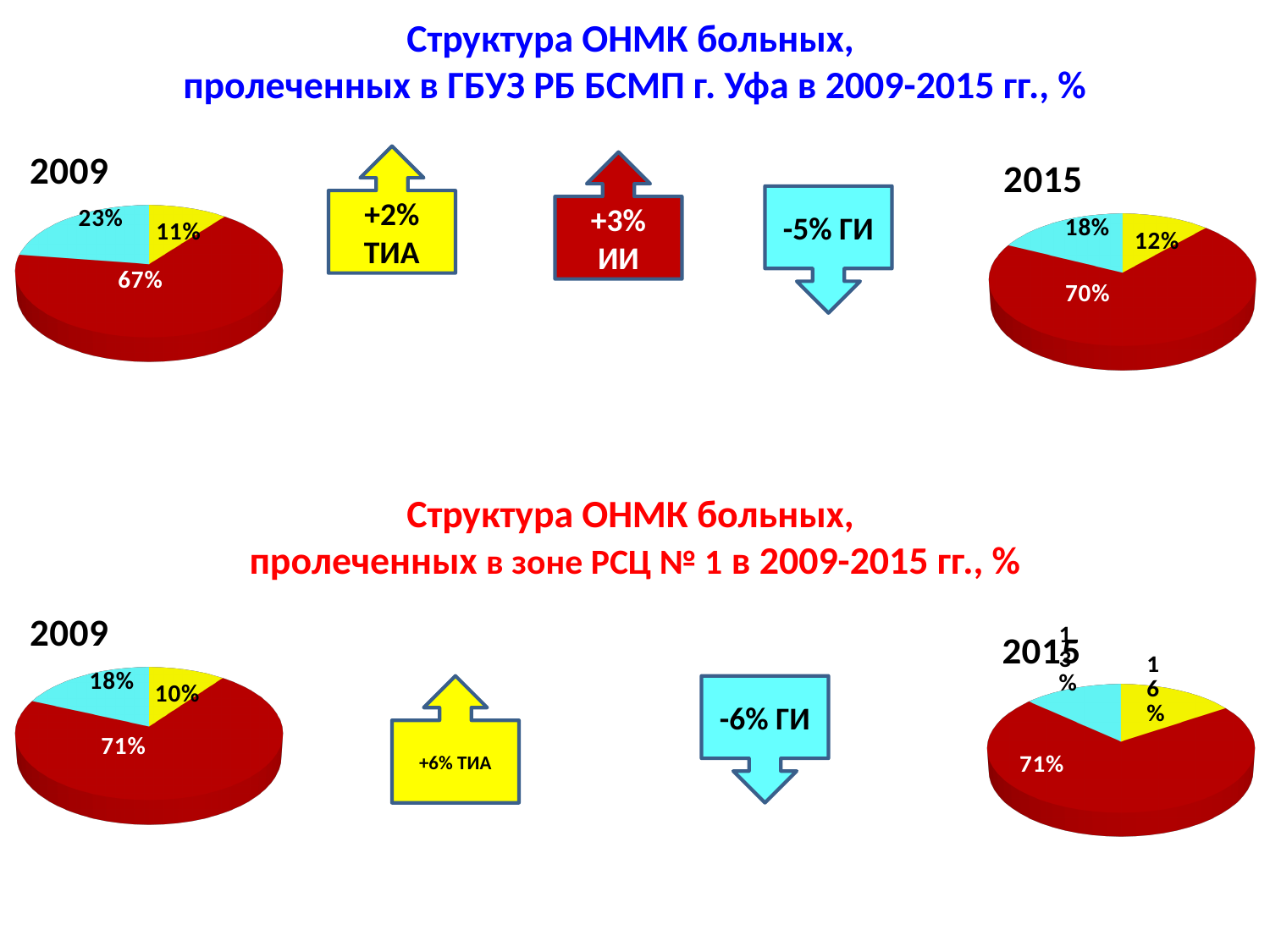
In the top-right pie chart (2015, БСМП), what percentage is shown for the red slice? 70% In the bottom-left pie chart (2009, РСЦ № 1), what percentage is shown for the cyan slice? 18% In the top-left pie chart (2009, БСМП), which colour slice is the largest? red In the bottom-right pie chart (2015, РСЦ № 1), what percentage is shown for the red slice? 71% How many slices does the bottom-left pie chart (2009, РСЦ № 1) have? 3 In the top-left pie chart (2009, БСМП), what percentage is shown for the red slice? 67% In the top-left pie chart (2009, БСМП), what is the difference between the red slice and the cyan slice? 44% In the top-right pie chart (2015, БСМП), what percentage is shown for the yellow slice? 12% In the top-left pie chart (2009, БСМП), what percentage is shown for the cyan slice? 23% What type of chart is used for the 2009 and 2015 data on this slide? pie chart In the top-right pie chart (2015, БСМП), which colour slice is the smallest? yellow In the bottom-left pie chart (2009, РСЦ № 1), what percentage is shown for the yellow slice? 10%